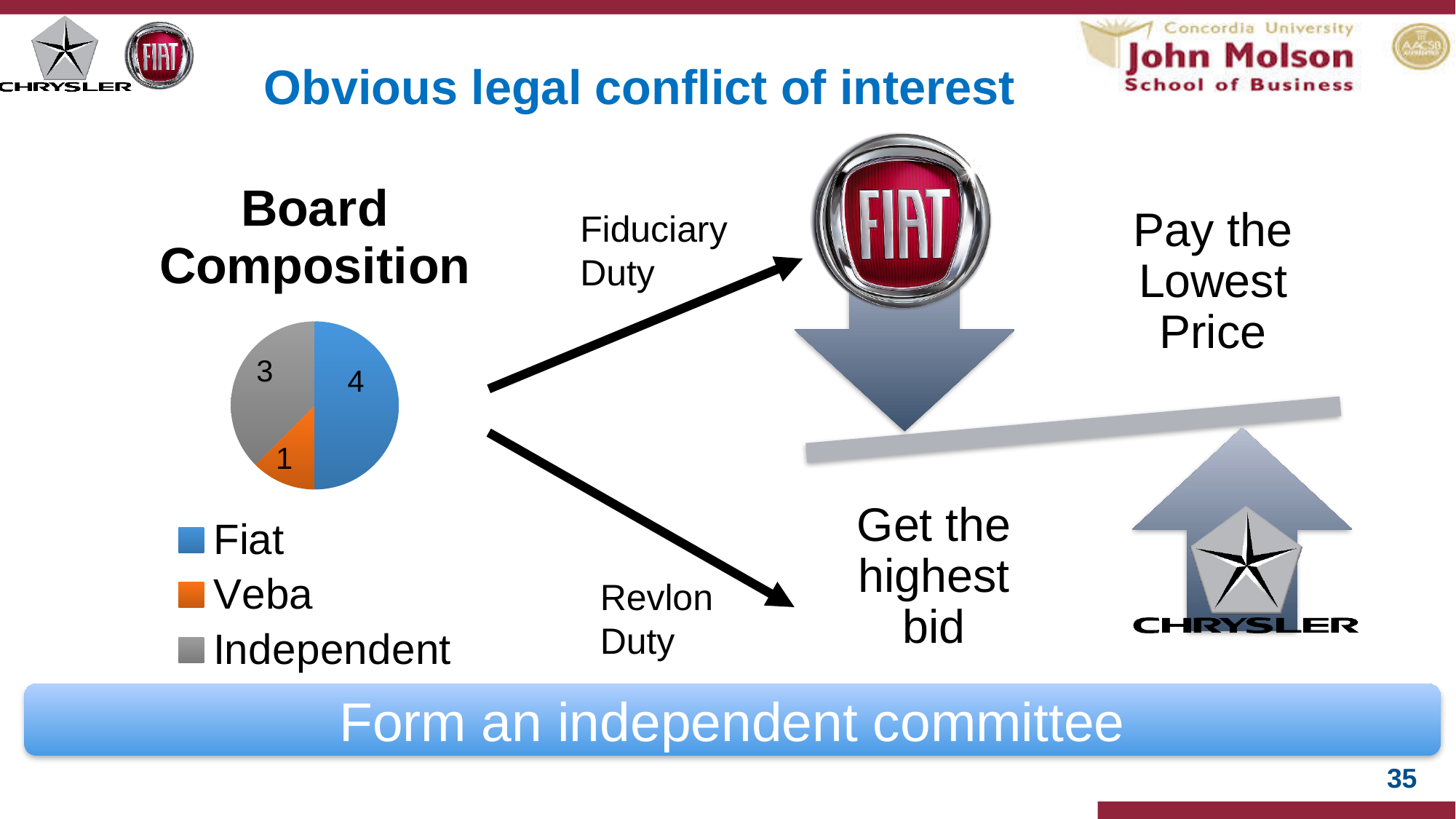
What kind of chart is shown under the heading 'Board Composition'? pie chart How many board seats are Independent according to the pie chart? 3 Which group holds the fewest board seats in the pie chart? Veba How many board seats does Veba hold according to the pie chart? 1 How many more seats does Fiat hold than Independent members? 1 How many board seats does Fiat hold according to the pie chart? 4 How many categories does the pie chart show? 3 Which holds more board seats, Independent or Veba? Independent How many more seats does Fiat hold than Veba? 3 Which group holds the most board seats in the pie chart? Fiat What colour represents Veba in the pie chart? orange What is the total number of board seats shown in the pie chart? 8